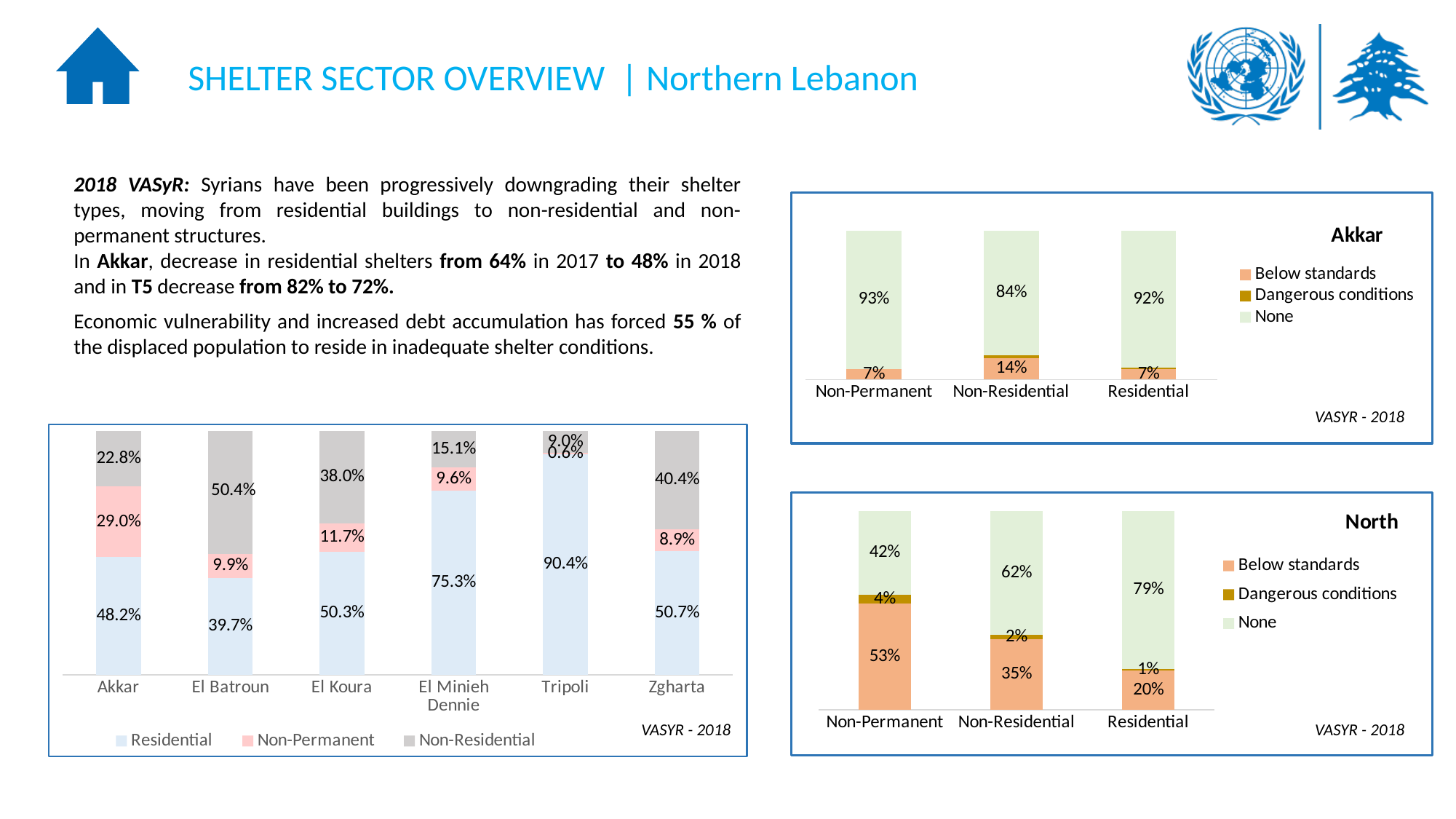
In the bottom-left chart, which district has the highest Non-Permanent share? Akkar In the bottom-left chart, what is the difference between the Residential shares of Tripoli and Akkar? 42.2% In the North chart, what is the difference between the None shares of Residential and Non-Permanent shelters? 37% In the bottom-left chart, what is the Non-Residential share for El Batroun? 50.4% In the bottom-left chart, what is the Residential share for Tripoli? 90.4% In the Akkar chart, which shelter type has the highest Below standards share? Non-Residential In the bottom-left chart, which district has the lowest Residential share? El Batroun What kind of chart is the North chart? Stacked bar chart In the North chart, what is the Below standards share for Non-Permanent shelters? 53% In the bottom-left chart, how many districts are shown on the x axis? 6 In the Akkar chart, what is the None share for Non-Residential shelters? 84% In the bottom-left chart, how many series does the legend list? 3